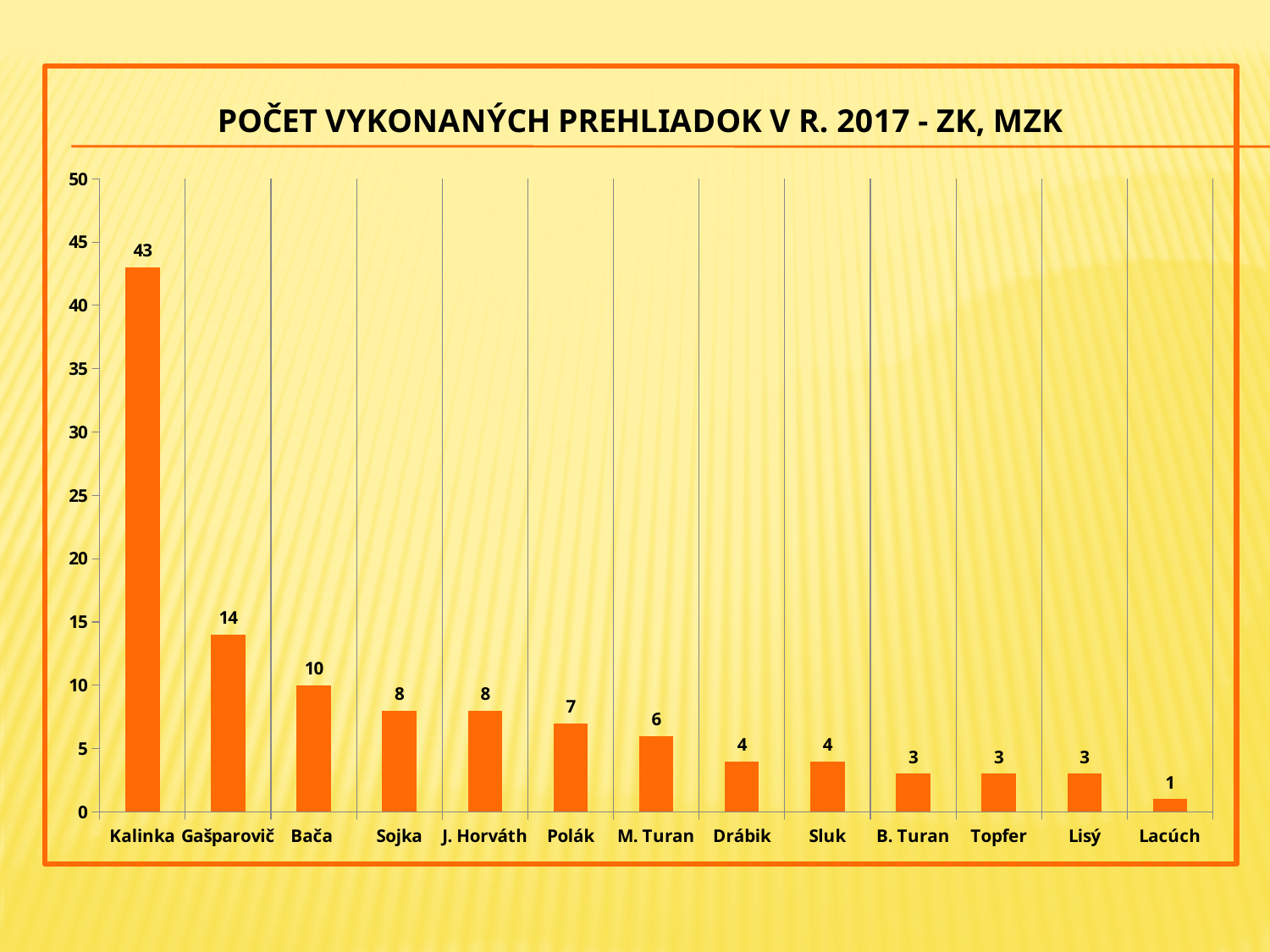
What kind of chart is this? bar chart What is the value for Poláк? 7 Which category has the highest value? Kalinka What is the value for Gašparovič? 14 Which category has the lowest value? Lacúch Is the value for Kalinka greater or less than 40? greater What is the title of the chart? POČET VYKONANÝCH PREHLIADOK V R. 2017 - ZK, MZK What is the difference between the values for Kalinka and Gašparovič? 29 Which is larger, the value for Sojka or the value for Drábik? Sojka How many categories are shown on the x axis? 13 What is the value for Kalinka? 43 What is the difference between the values for Bača and M. Turan? 4